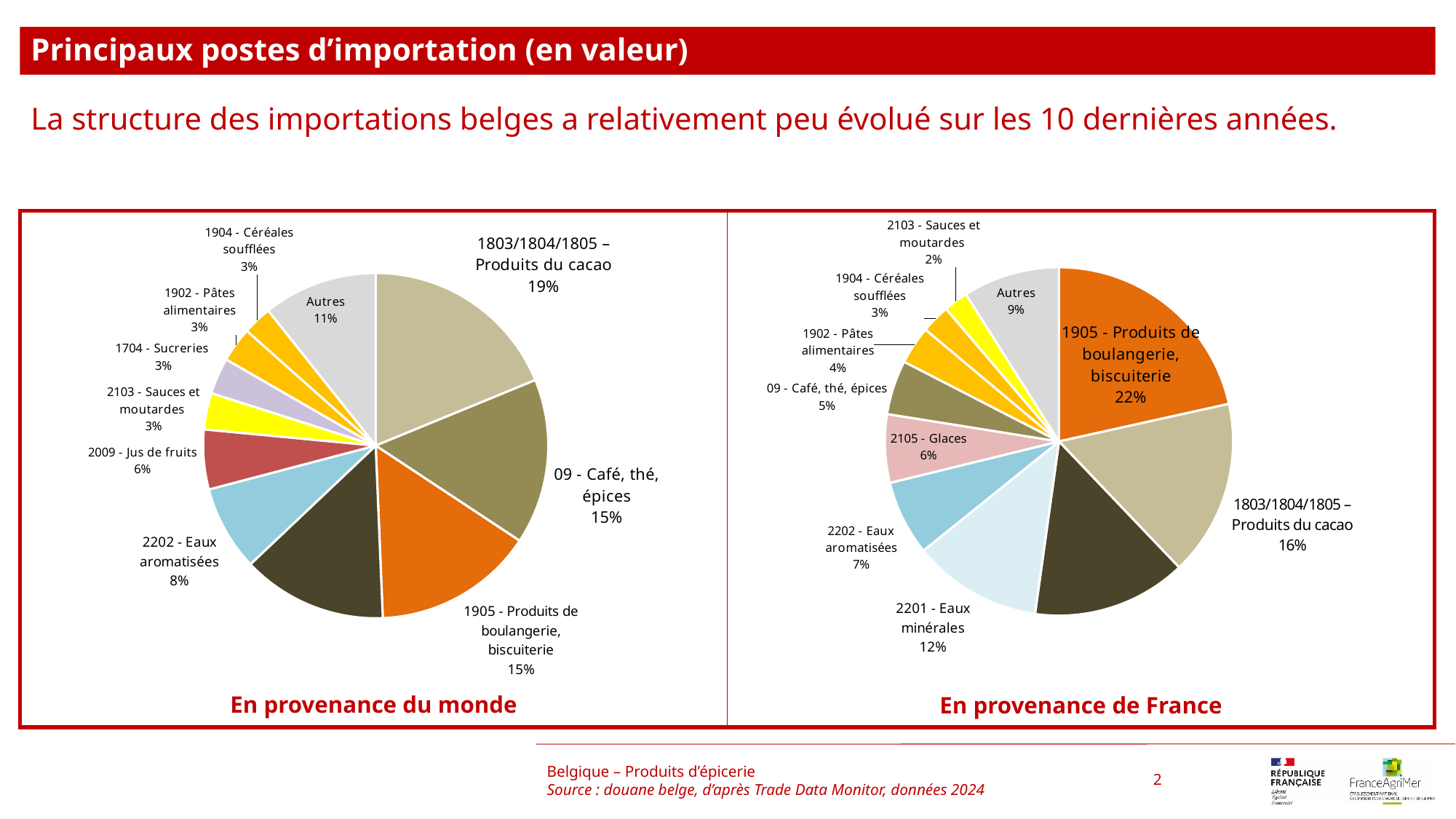
What type of chart is used for 'En provenance de France'? Pie chart In the 'En provenance du monde' pie chart, what share is shown for 2202 - Eaux aromatisées? 8% Which is larger: the share of 09 - Café, thé, épices in the 'En provenance du monde' chart or in the 'En provenance de France' chart? En provenance du monde In the 'En provenance de France' pie chart, what is the difference in percentage points between 1905 - Produits de boulangerie, biscuiterie and 1803/1804/1805 – Produits du cacao? 6 percentage points In the 'En provenance de France' pie chart, what share is shown for 2105 - Glaces? 6% What is the title of the slide? Principaux postes d’importation (en valeur) In the 'En provenance du monde' pie chart, what is the difference in percentage points between 2202 - Eaux aromatisées and 2009 - Jus de fruits? 2 percentage points In the 'En provenance de France' pie chart, what share is shown for 1905 - Produits de boulangerie, biscuiterie? 22% In the 'En provenance de France' pie chart, what share is shown for 2201 - Eaux minérales? 12% In the 'En provenance de France' pie chart, which labelled category has the smallest share? 2103 - Sauces et moutardes In the 'En provenance du monde' pie chart, which labelled category has the largest share? 1803/1804/1805 – Produits du cacao In the 'En provenance du monde' pie chart, what share is shown for 1803/1804/1805 – Produits du cacao? 19%